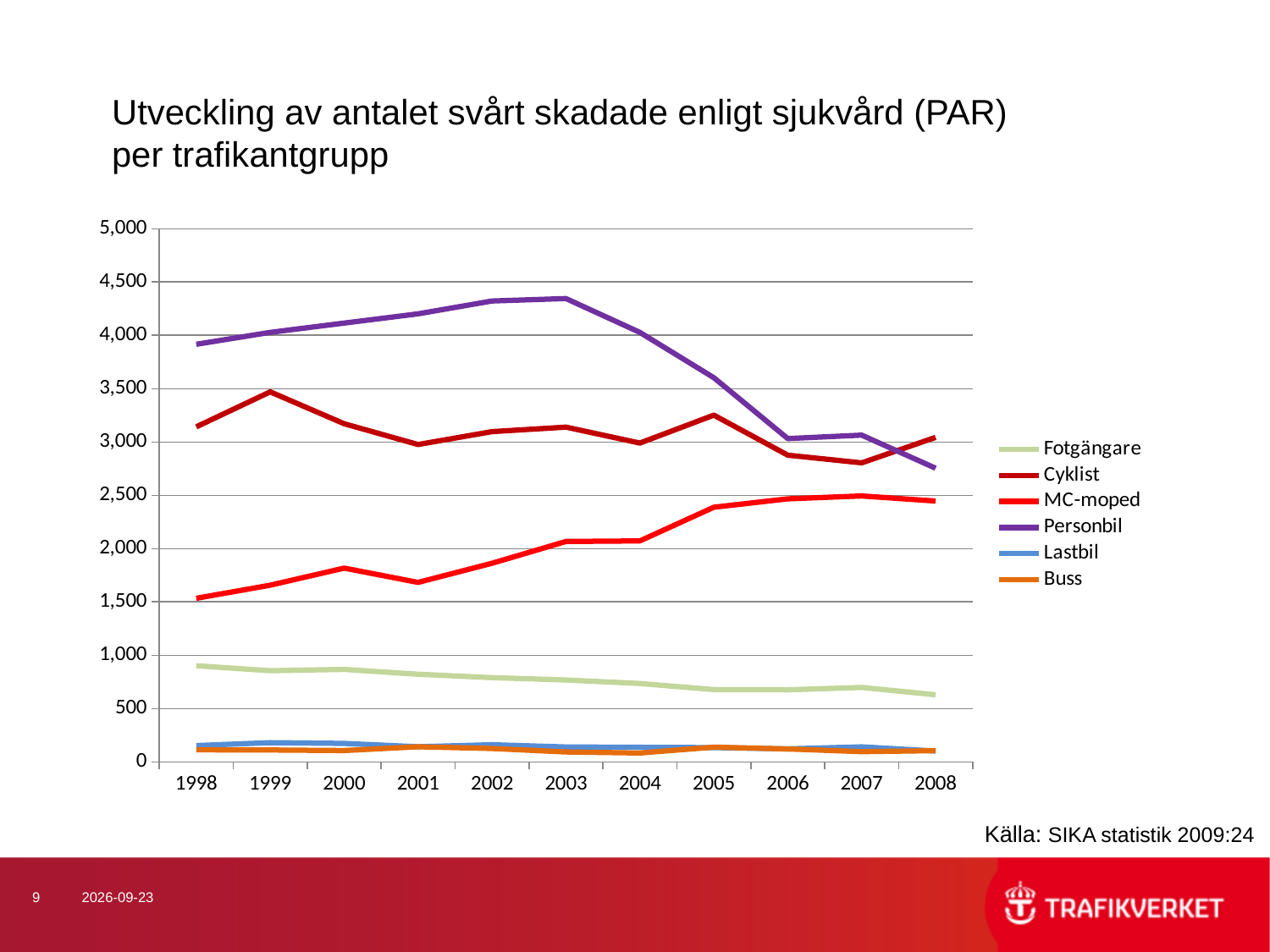
Is the value for Personbil in 2003 greater or less than 4,000? greater Does the Personbil series rise or fall from 2003 to 2008? fall Is the value for MC-moped in 1998 greater or less than 2,000? less How many years are shown on the x axis? 11 Which series has the highest value in 1998? Personbil How many series does the legend list? 6 In which year does the Cyklist series reach its highest value? 1999 Which is larger in 2000, Cyklist or MC-moped? Cyklist Which series has the highest value in 2008? Cyklist Does the MC-moped series generally rise or fall from 1998 to 2008? rise Is the value for Fotgängare in 1998 greater or less than 1,000? less What kind of chart is shown on the slide? line chart